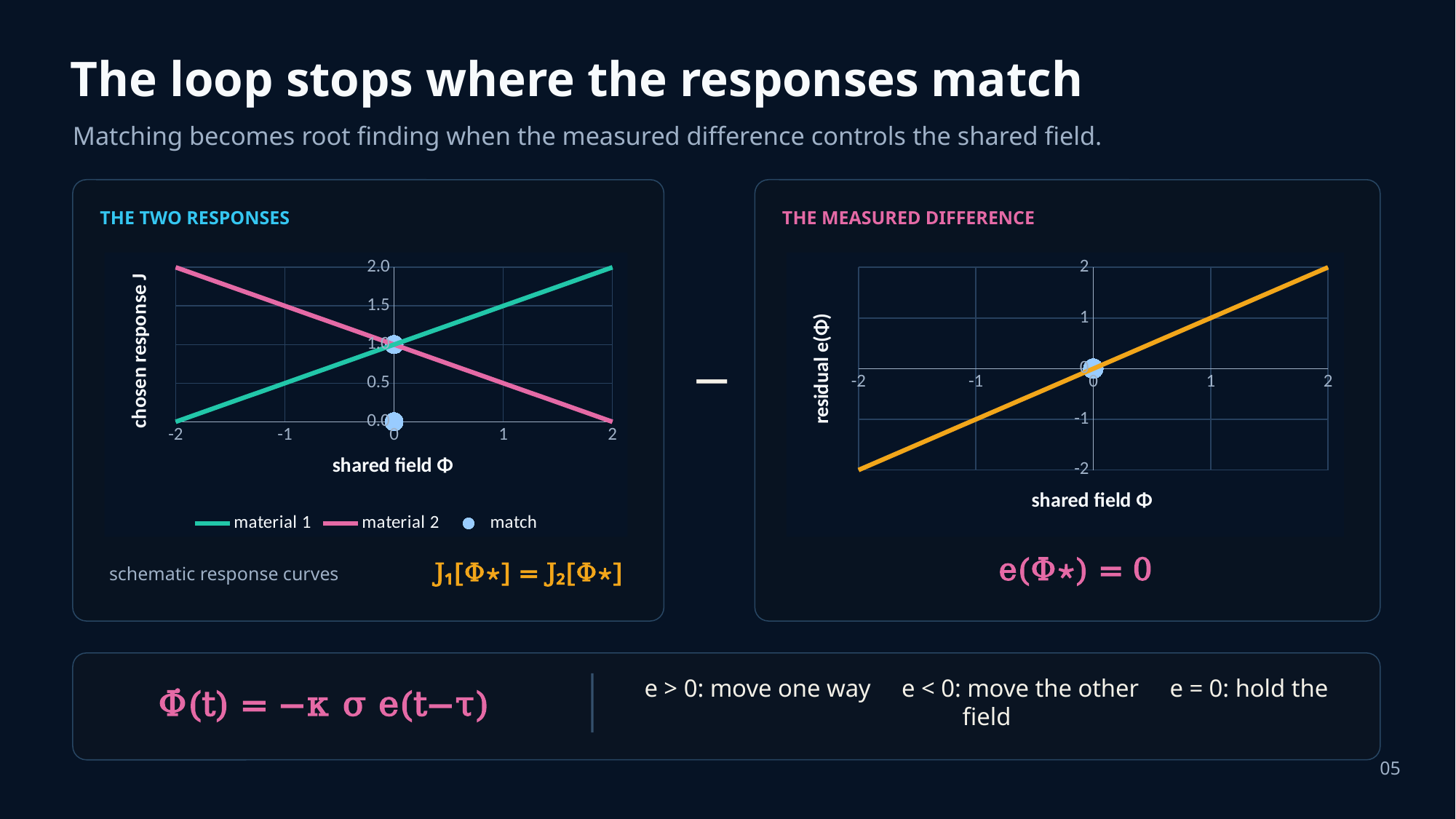
What is the y-axis title of the 'THE MEASURED DIFFERENCE' chart? residual e(Φ) In the 'THE MEASURED DIFFERENCE' chart, does the residual e(Φ) rise or fall as the shared field Φ increases? rises In the 'THE MEASURED DIFFERENCE' chart, is the residual at Φ = -2 greater or less than -1? less In the 'THE TWO RESPONSES' chart, what is the value of material 1 at Φ = 2? 2.0 In the 'THE TWO RESPONSES' chart, does the material 1 line rise or fall as the shared field Φ increases? rises In the 'THE TWO RESPONSES' chart, is the value of material 1 at Φ = 2 greater or less than 1.5? greater In the 'THE TWO RESPONSES' chart, is the value of material 2 at Φ = 2 greater or less than 0.5? less In the 'THE TWO RESPONSES' chart, at shared field Φ = -2, which is larger, material 1 or material 2? material 2 In the 'THE TWO RESPONSES' chart, does the material 2 line rise or fall as the shared field Φ increases? falls How many series does the legend of the 'THE TWO RESPONSES' chart list? 3 What kind of chart is shown in the 'THE TWO RESPONSES' panel? line chart